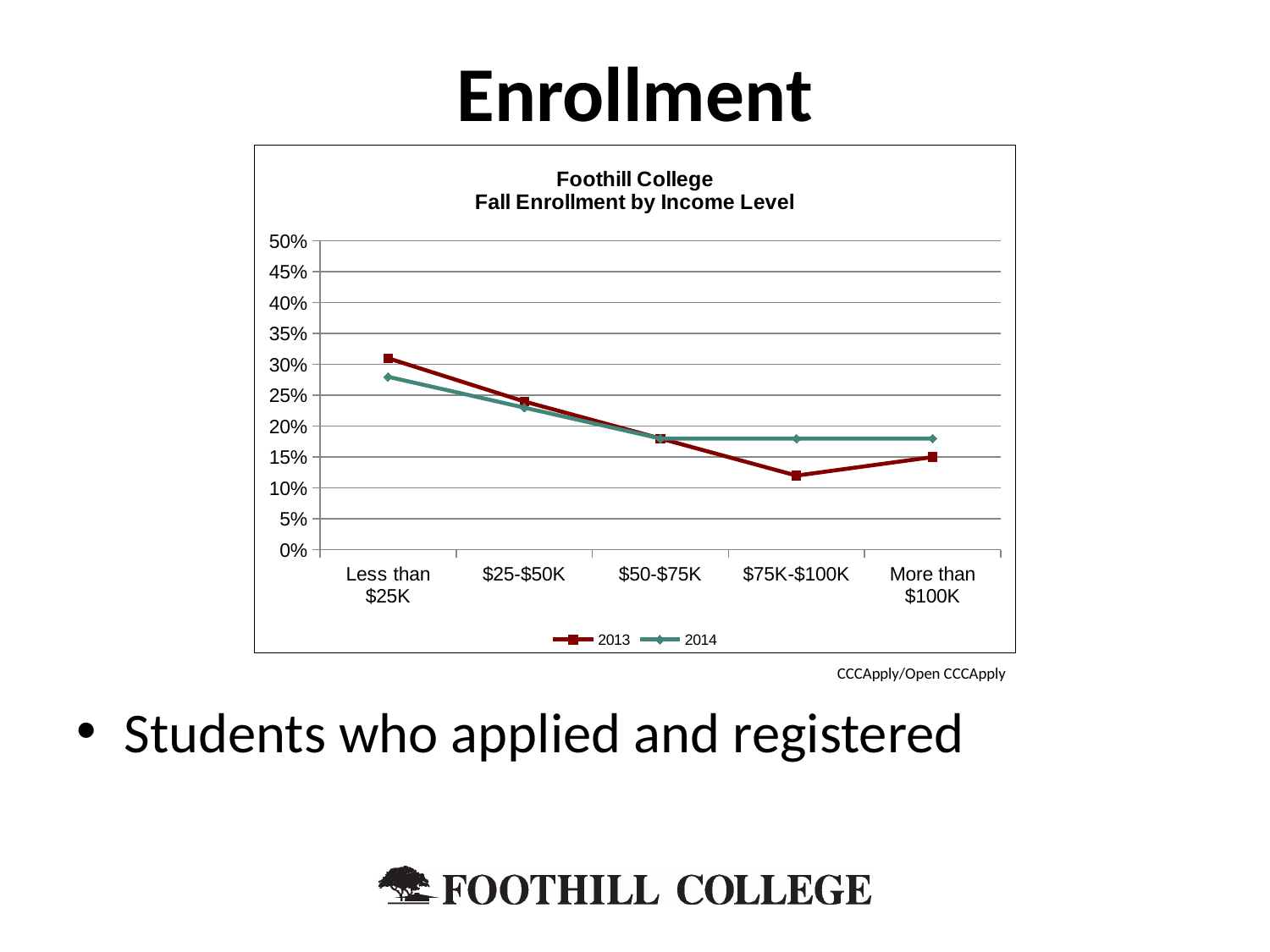
What is the title of the chart? Foothill College Fall Enrollment by Income Level Is the 2014 value for $75K-$100K greater or less than 15%? greater How many series does the legend list? 2 Which income level has the highest value for the 2014 series? Less than $25K Is the 2013 value for $75K-$100K greater or less than 15%? less What kind of chart is shown on the slide? line chart How many income level categories are shown on the x axis? 5 Which income level has the highest value for the 2013 series? Less than $25K Is the 2013 value for Less than $25K greater or less than 25%? greater Does the 2013 series rise or fall from Less than $25K to $75K-$100K? fall For the $75K-$100K income level, which series has the larger value, 2013 or 2014? 2014 Which income level has the lowest value for the 2013 series? $75K-$100K